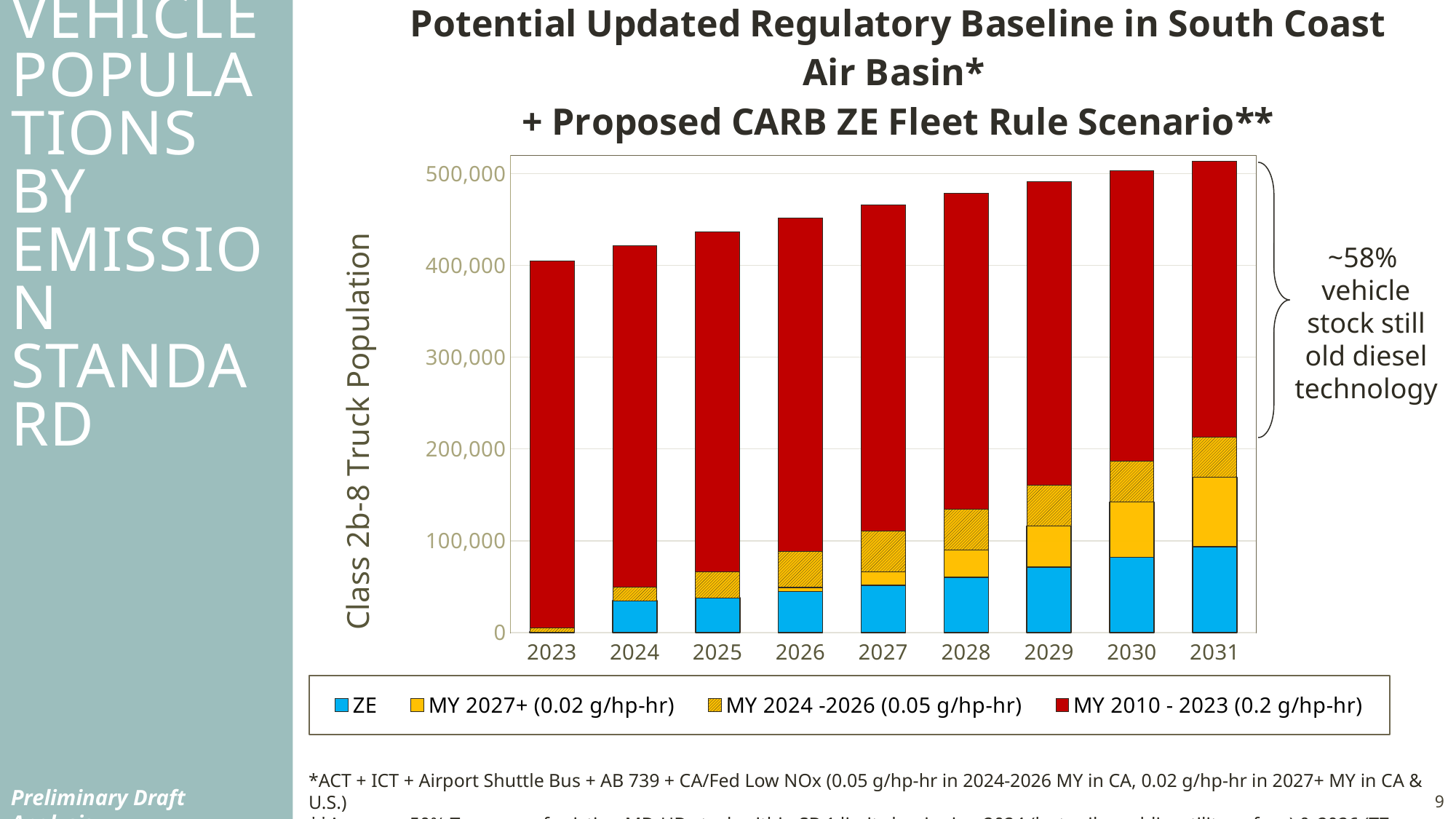
What kind of chart is shown on the slide? Stacked bar chart How many series does the chart legend list? 4 Is the ZE segment larger in 2024 or in 2031? 2031 Does the total Class 2b-8 truck population rise or fall from 2023 to 2031? Rises According to the annotation next to the 2031 bar, roughly what share of the vehicle stock is still old diesel technology? ~58% Is the ZE segment for 2030 greater or less than 100,000? less What is the label on the y axis of the chart? Class 2b-8 Truck Population Which year has the largest total truck population? 2031 Is the total truck population for 2031 greater or less than 500,000? greater Is the total truck population for 2023 greater or less than 500,000? less How many years are shown along the x axis of the chart? 9 Which year has the smallest total truck population? 2023